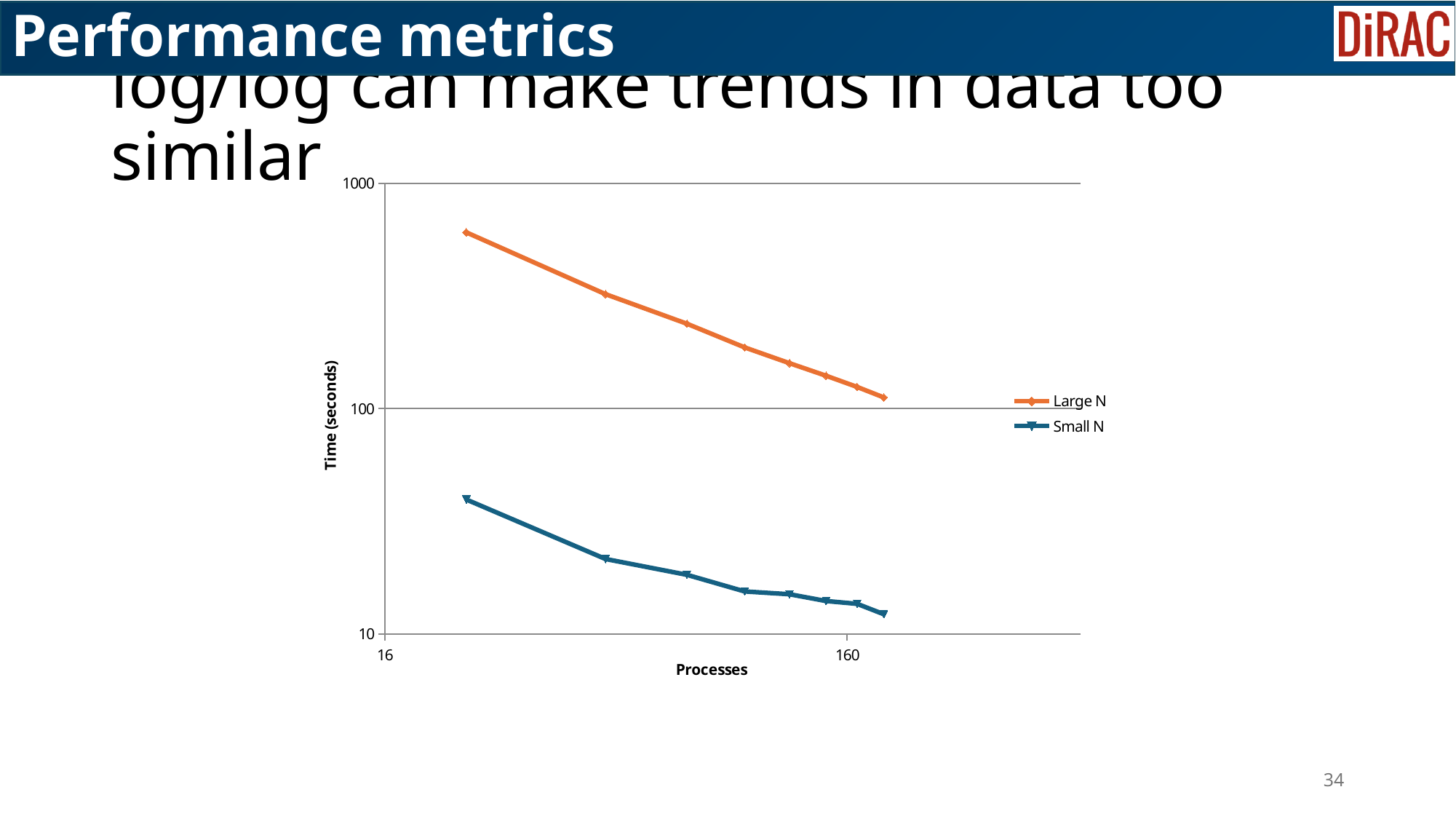
Is the first (leftmost) value for Large N greater or less than 100? greater Which series has the higher time values across the chart, Large N or Small N? Large N What is the label of the y axis? Time (seconds) Is the first (leftmost) value for Small N greater or less than 100? less Do the values for Small N rise or fall as the number of processes increases? fall Do the values for Large N rise or fall as the number of processes increases? fall How many data points are plotted for the Small N series? 8 How many data points are plotted for the Large N series? 8 What are the names of the two series in the legend? Large N and Small N What kind of chart is shown on the slide? line chart How many series does the chart's legend list? 2 Is the first (leftmost) value for Large N greater or less than 1000? less